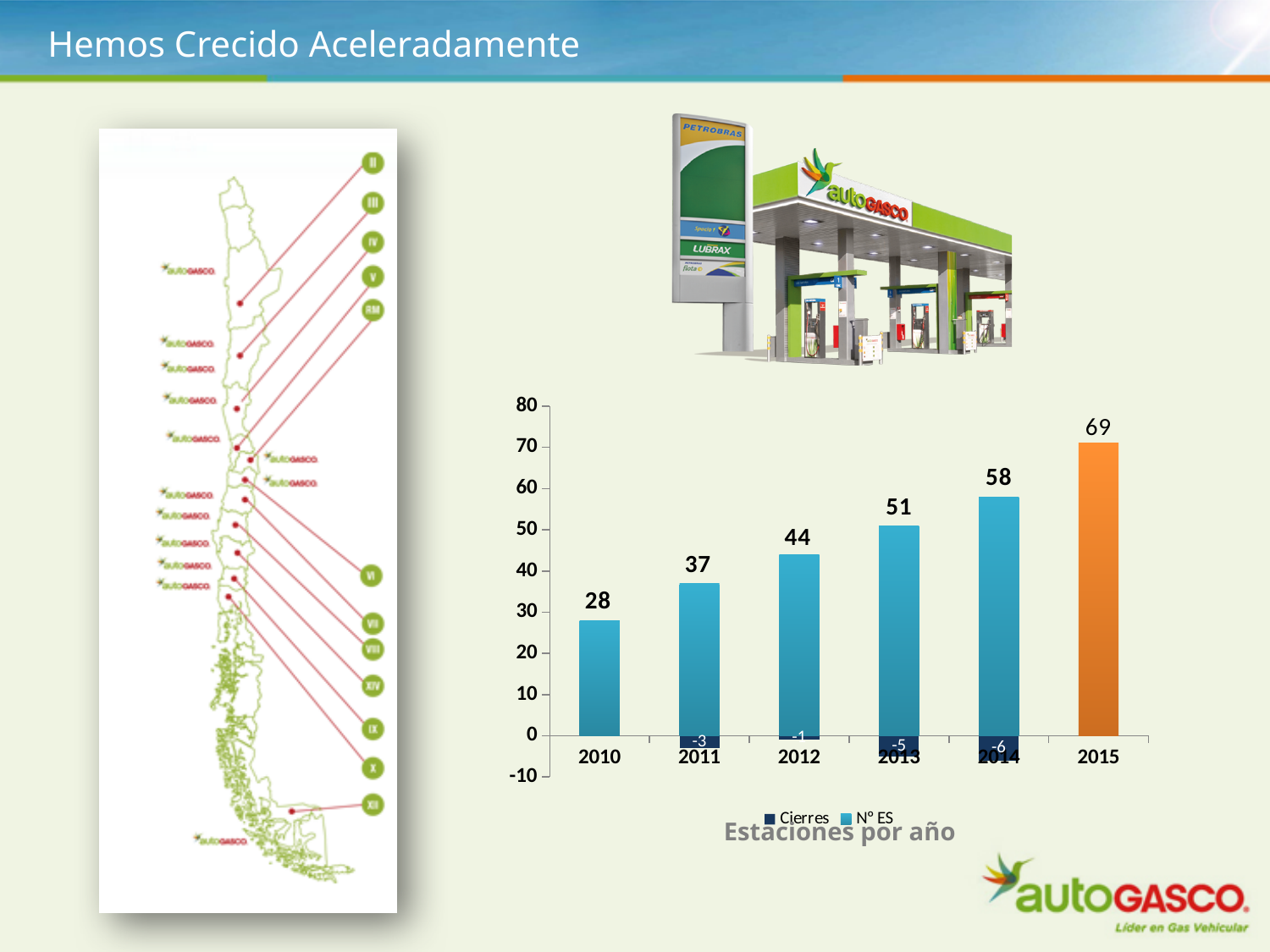
What is the Nº ES value for 2012? 44 Which is larger, the Nº ES value for 2011 or for 2013? 2013 Is the Nº ES value for 2013 greater or less than 40? greater What is the difference between the Nº ES values for 2014 and 2010? 30 How many years are shown on the x axis? 6 How many series does the legend list? 2 What is the Nº ES value for 2015? 69 Which year has the highest Nº ES value? 2015 What kind of chart is shown? bar chart Do the Nº ES values rise or fall from 2010 to 2015? rise What is the Cierres value for 2013? -5 Which year has the lowest Nº ES value? 2010